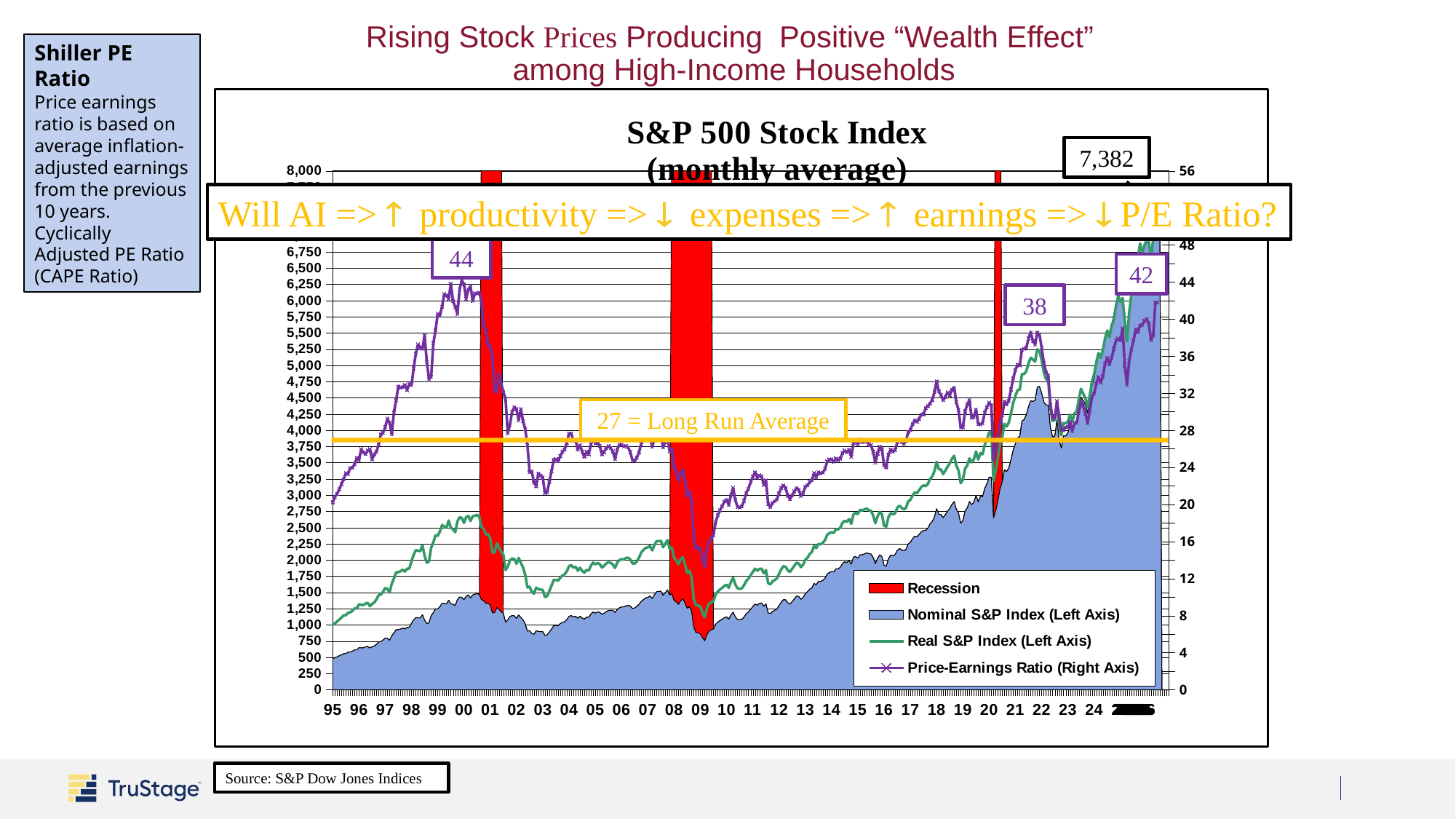
What Price-Earnings Ratio value is labeled at the right end of the chart? 42 What Price-Earnings Ratio value is labeled around 2021? 38 How many series does the chart's legend list? 4 Does the Nominal S&P Index rise or fall from 2020 to 2024? rise Which labeled Price-Earnings Ratio value is larger, the one around 2000 or the one at the right end of the chart? The one around 2000 (44) How many recession periods are shaded on the chart? 3 What is the difference between the labeled Price-Earnings Ratio peak of 44 and the long run average of 27? 17 Is the Nominal S&P Index at its 2009 low greater or less than 1,000? less What is the title of the chart on the slide? S&P 500 Stock Index (monthly average) What value is labeled for the Nominal S&P Index at the right end of the chart? 7,382 What value is labeled for the Price-Earnings Ratio peak around 2000? 44 What is the long run average Price-Earnings Ratio shown on the chart? 27